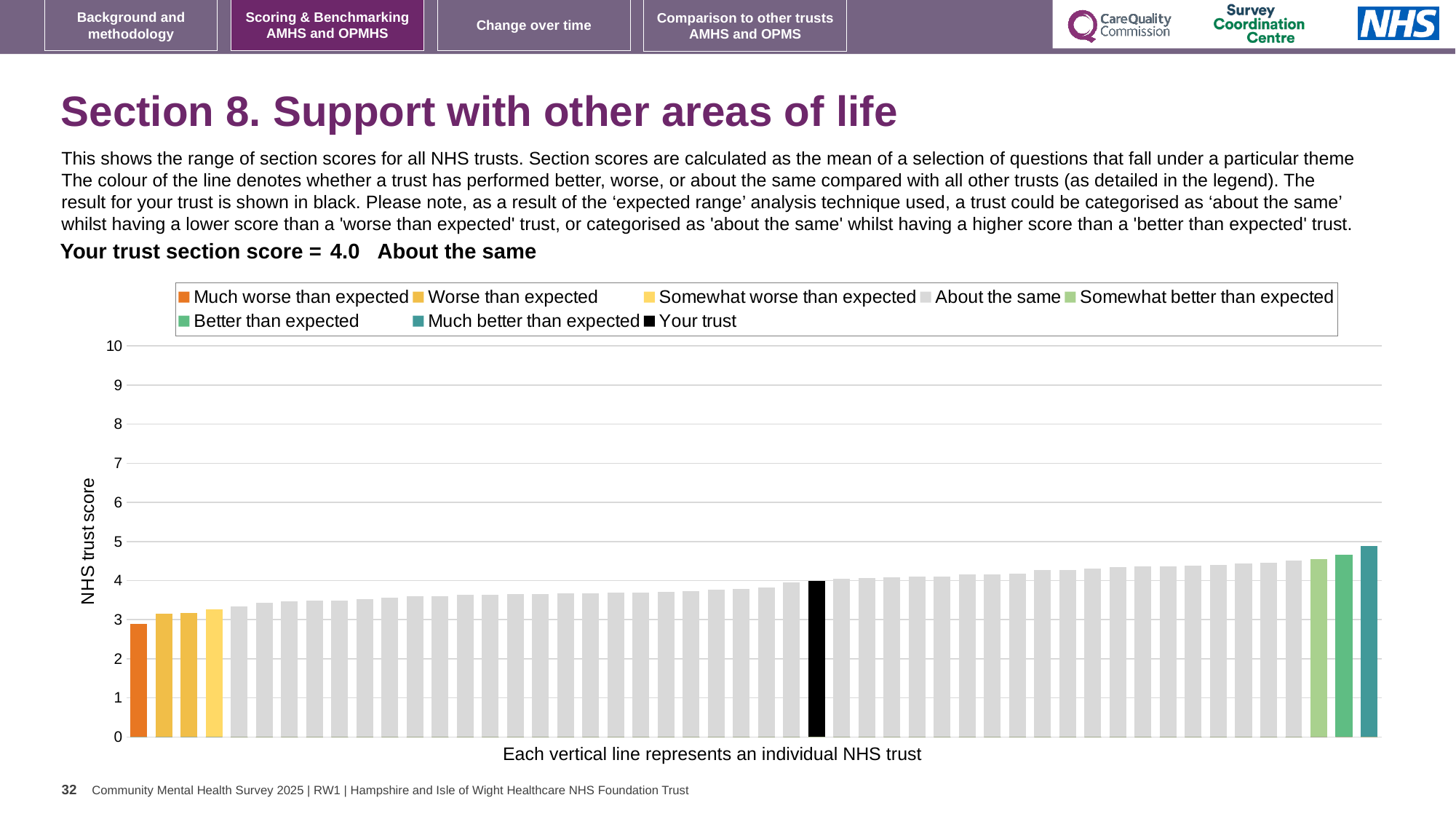
What kind of chart is shown on the slide? bar chart Do the bar values rise or fall from left to right along the x axis? rise How many entries does the chart legend list? 8 Is the value of the tallest bar greater or less than 4? greater What is the section score for your trust? 4.0 Which category is your trust placed in for this section? About the same Is the black bar for your trust taller or shorter than the orange bar? taller Is the value for your trust (the black bar) greater or less than 5? less Which legend category does the shortest bar belong to? Much worse than expected Which legend category does the tallest bar belong to? Much better than expected Is the value of the shortest bar greater or less than 4? less What is the label on the vertical axis of the chart? NHS trust score